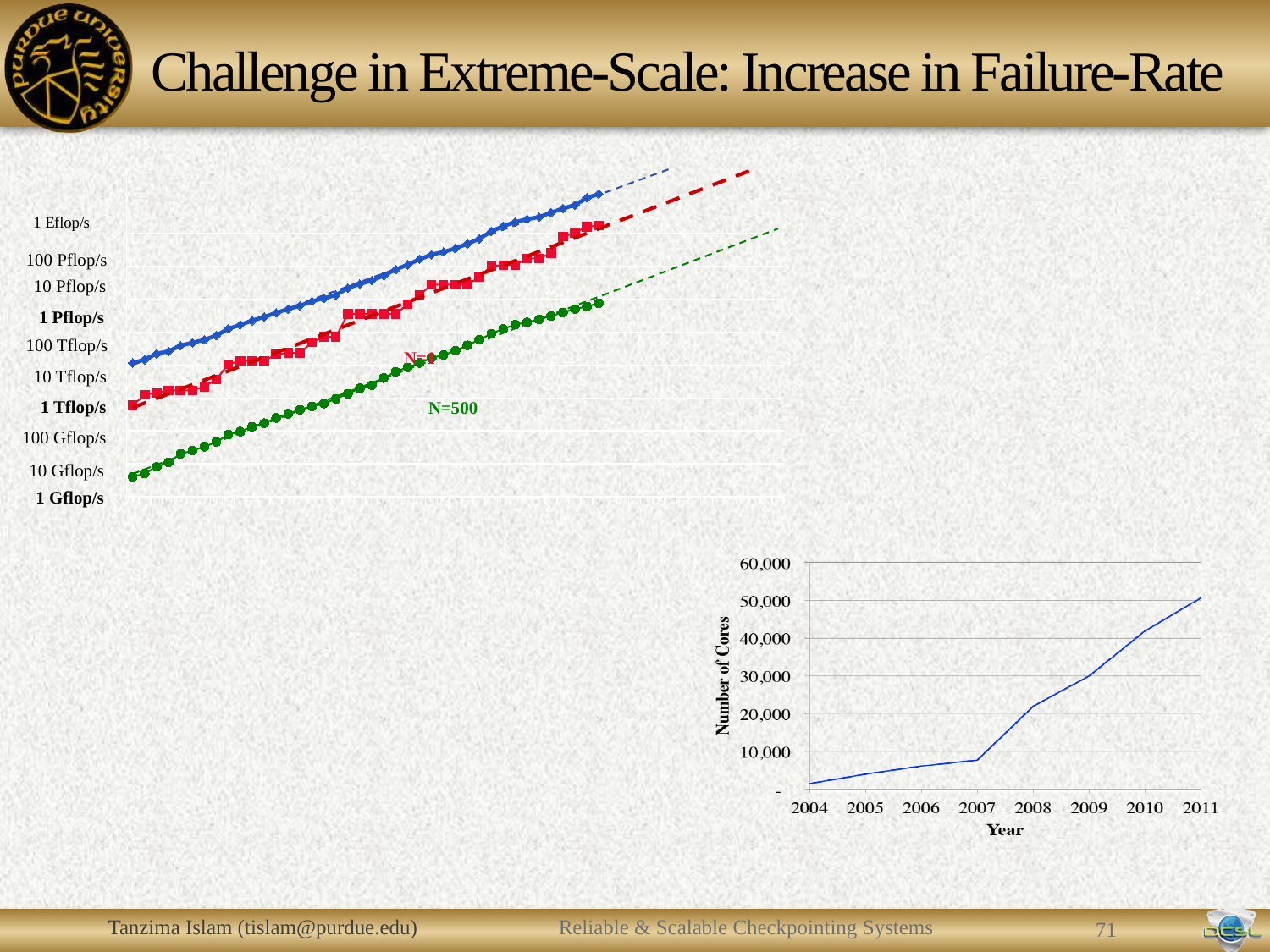
In the bottom-right chart, is the number of cores for 2011 greater or less than 40,000? greater In the bottom-right chart, how many years are shown on the x axis? 8 What kind of chart is the bottom-right chart with the 'Number of Cores' axis? line chart In the bottom-right chart, is the number of cores for 2007 greater or less than 10,000? less In the bottom-right chart, which year has the lowest number of cores? 2004 In the bottom-right chart, which year has the highest number of cores? 2011 In the top-left chart with the flop/s axis, do the plotted lines rise or fall along the x axis? rise In the bottom-right chart, which year has more cores, 2006 or 2008? 2008 In the bottom-right chart, does the number of cores rise or fall from 2004 to 2011? rise What is the title of the vertical axis of the bottom-right chart? Number of Cores In the top-left chart with the flop/s axis, how many lines are plotted? 3 In the bottom-right chart, is the number of cores for 2009 greater or less than 20,000? greater